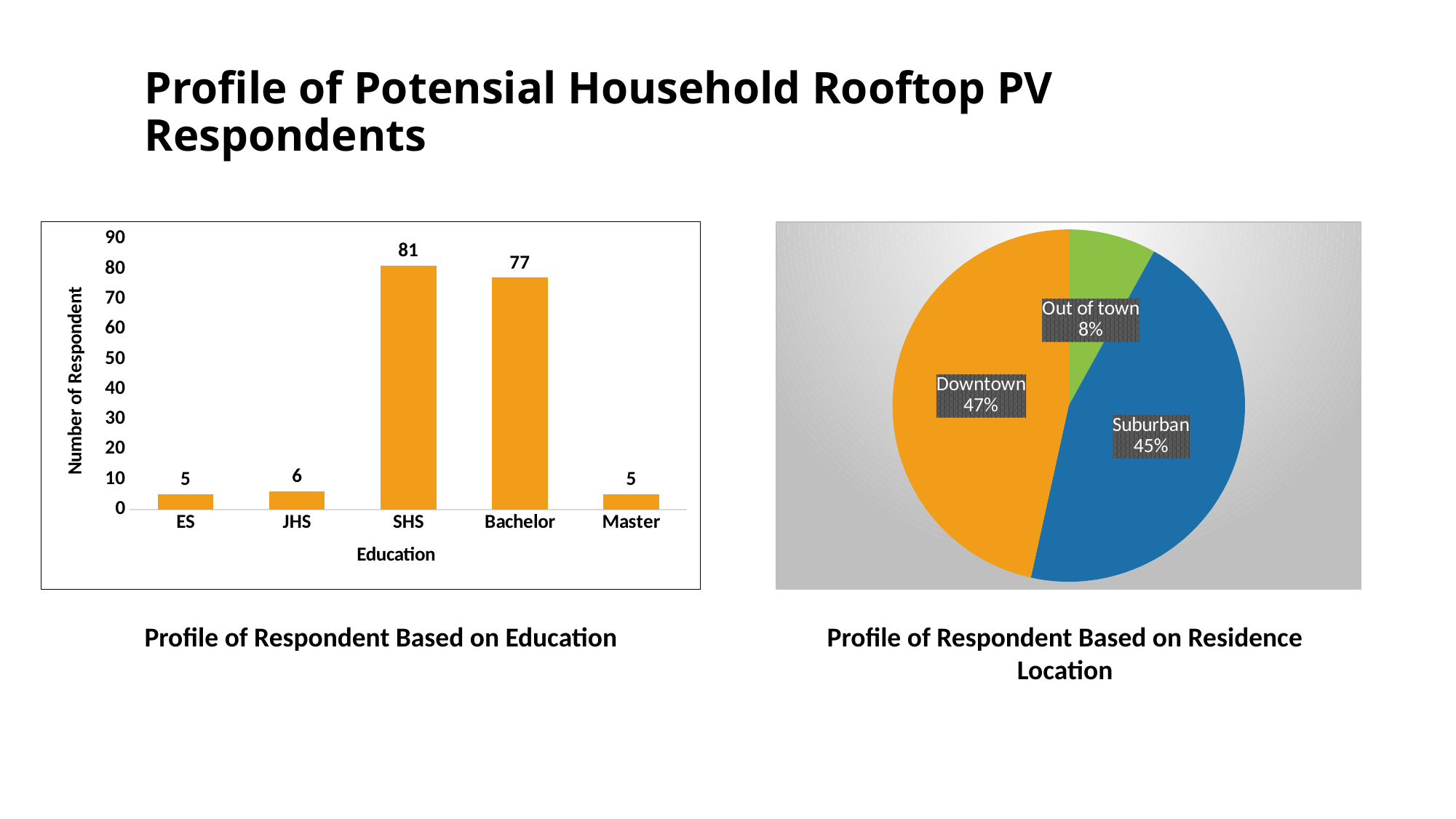
In the 'Profile of Respondent Based on Education' chart, what is the number of respondents for SHS? 81 In the 'Profile of Respondent Based on Education' chart, which is larger, the value for ES or the value for JHS? JHS What kind of chart is 'Profile of Respondent Based on Education'? Bar chart In the 'Profile of Respondent Based on Residence Location' chart, what share of respondents live Downtown? 47% In the 'Profile of Respondent Based on Education' chart, what is the number of respondents for JHS? 6 In the 'Profile of Respondent Based on Education' chart, how many education categories are shown on the x axis? 5 In the 'Profile of Respondent Based on Education' chart, what is the number of respondents for Bachelor? 77 In the 'Profile of Respondent Based on Residence Location' chart, what share of respondents live Out of town? 8% In the 'Profile of Respondent Based on Education' chart, which education level has the highest number of respondents? SHS In the 'Profile of Respondent Based on Education' chart, what is the difference between the SHS and Bachelor values? 4 What kind of chart is 'Profile of Respondent Based on Residence Location'? Pie chart In the 'Profile of Respondent Based on Residence Location' chart, which residence location has the smallest share? Out of town